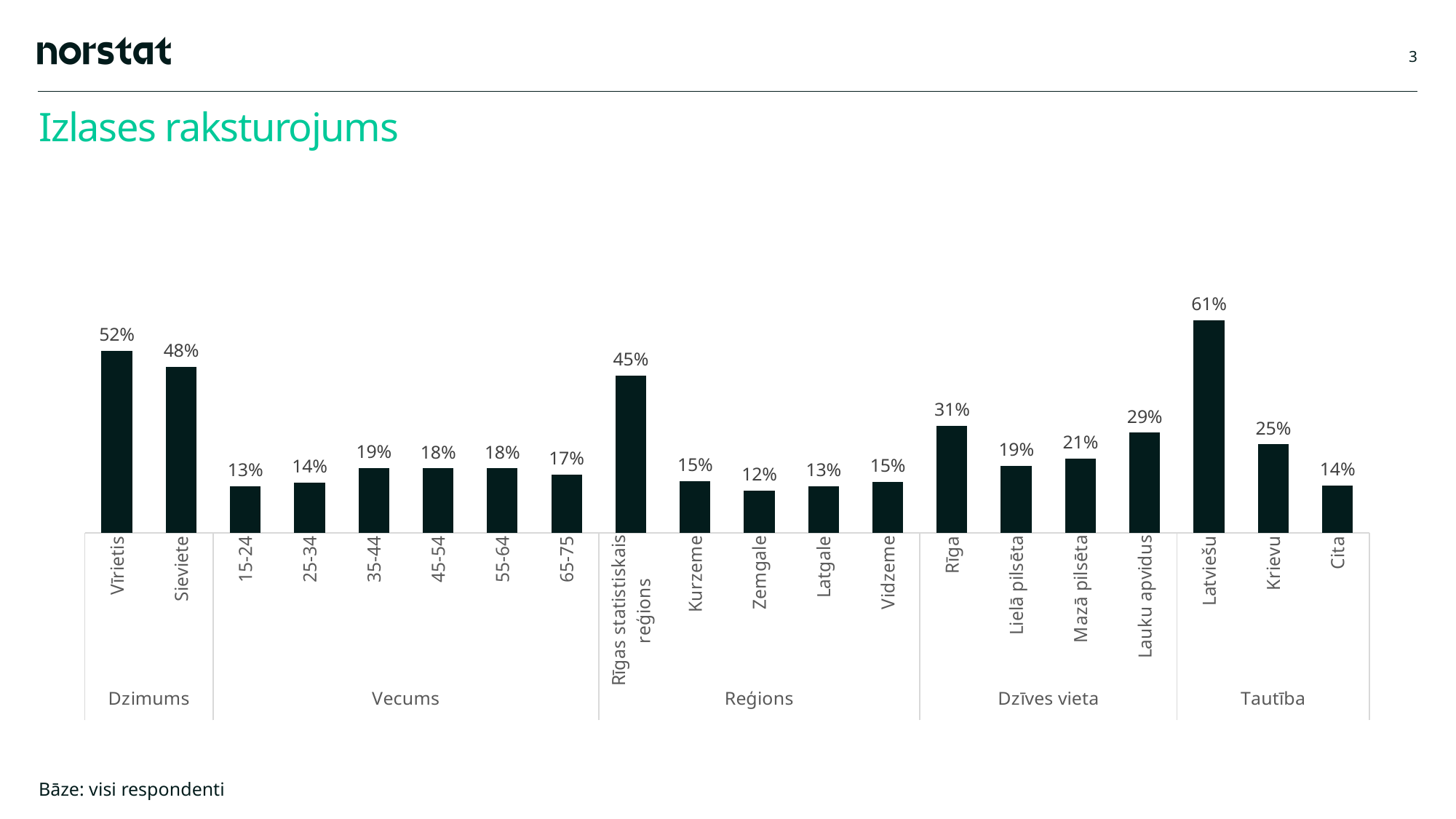
What is the value for Lauku apvidus? 29% Which category has the lowest value on the chart? Zemgale Which category has the highest value on the chart? Latviešu What is the difference between the values for Latviešu and Krievu? 36% What kind of chart is shown on the slide? Bar chart How many age groups are shown in the Vecums section? 6 What is the value for Vīrietis? 52% What is the difference between the values for Vīrietis and Sieviete? 4% What is the value for Rīgas statistiskais reģions? 45% What is the title of the slide? Izlases raksturojums How many categories are shown in the Reģions section? 5 Which is larger, the value for Rīga or the value for Lielā pilsēta? Rīga